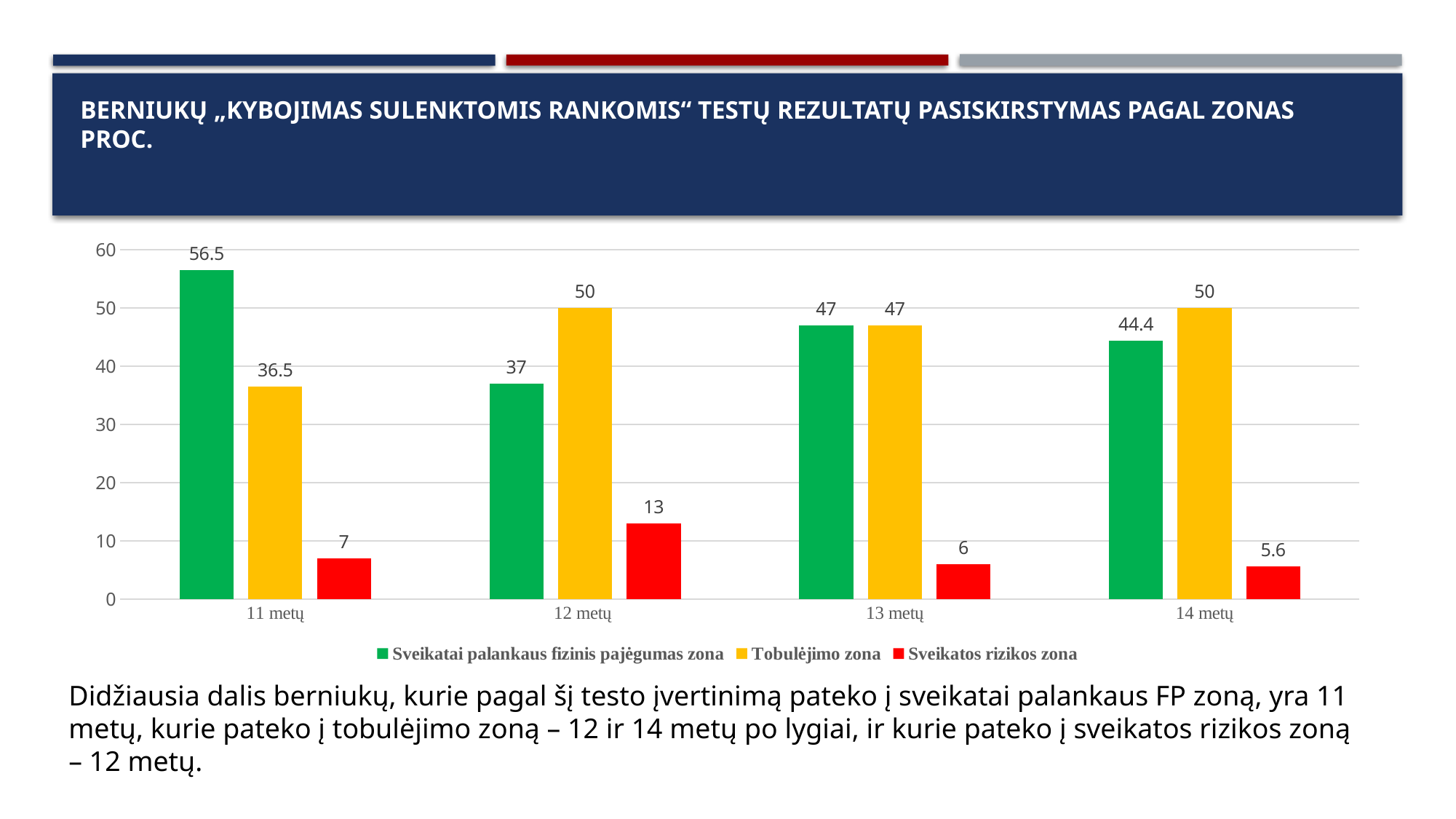
Which colour represents 'Sveikatos rizikos zona' in the legend? Red What kind of chart is shown on the slide? Bar chart Which is larger at 14 metų: 'Sveikatai palankaus fizinis pajėgumas zona' or 'Tobulėjimo zona'? Tobulėjimo zona How many series does the legend list? 3 How many age groups are shown on the x axis? 4 Which age group has the highest value for 'Sveikatos rizikos zona'? 12 metų Is the value for 'Tobulėjimo zona' at 12 metų greater or less than 40? greater What is the value for 'Sveikatos rizikos zona' at 14 metų? 5.6 Which age group has the lowest value for 'Sveikatai palankaus fizinis pajėgumas zona'? 12 metų What is the difference between the 'Sveikatai palankaus fizinis pajėgumas zona' and 'Tobulėjimo zona' values at 11 metų? 20 What is the value for 'Sveikatai palankaus fizinis pajėgumas zona' at 11 metų? 56.5 What is the value for 'Tobulėjimo zona' at 13 metų? 47